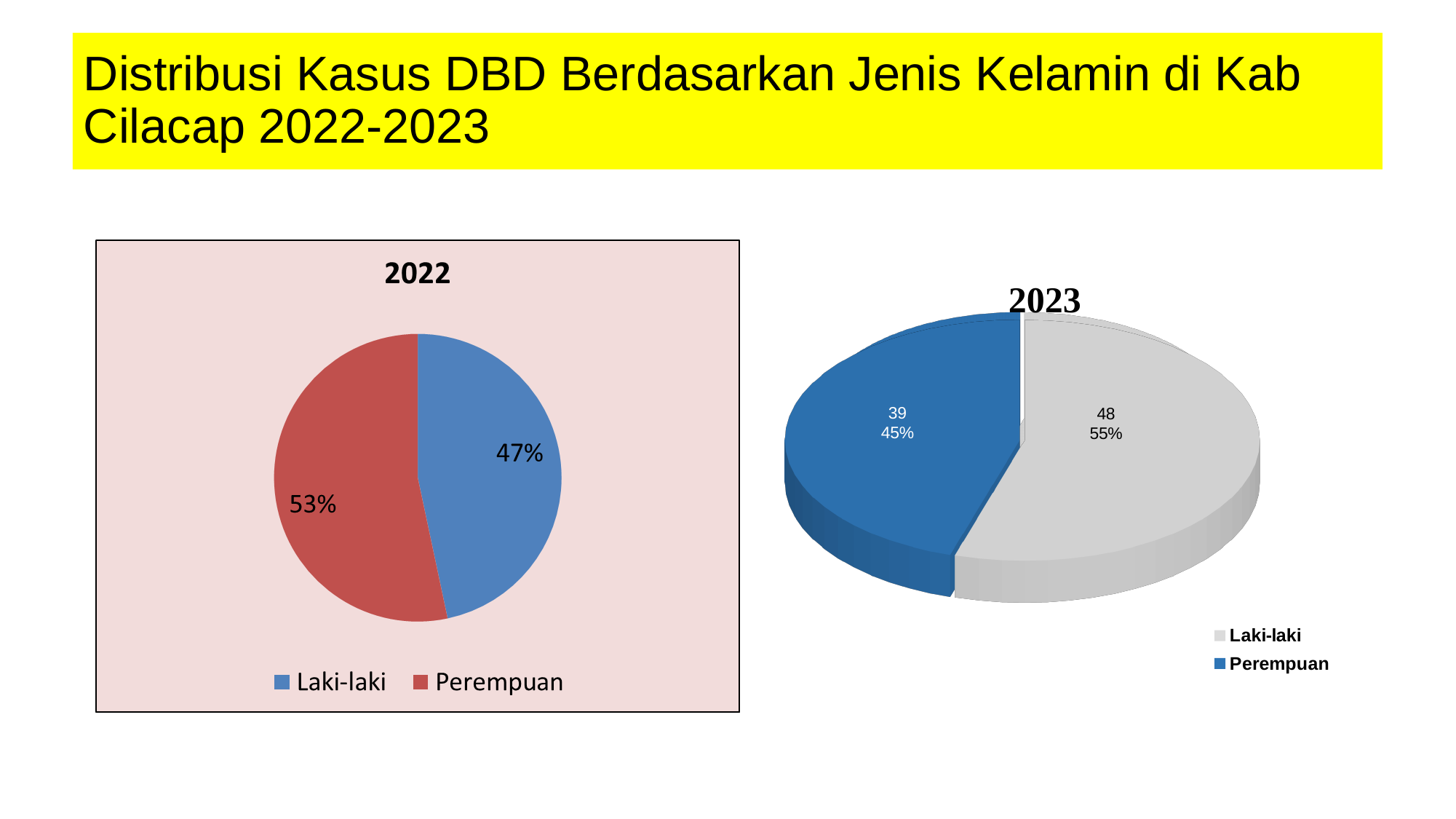
In the 2022 chart, which category has the larger share? Perempuan In the 2023 chart, what is the total number of cases? 87 What type of chart is the 2022 chart? Pie chart In the 2023 chart, how many cases are Perempuan? 39 In the 2023 chart, what is the difference between the Laki-laki and Perempuan case counts? 9 How many categories does the legend of the 2023 chart list? 2 In the 2022 chart, what share of cases is Laki-laki? 47% In the 2023 chart, which category has the smaller number of cases? Perempuan In the 2023 chart, how many cases are Laki-laki? 48 In the 2022 chart, what share of cases is Perempuan? 53% In the 2022 chart, what is the difference in percentage points between Perempuan and Laki-laki? 6 percentage points In the 2023 chart, what share of cases is Laki-laki? 55%